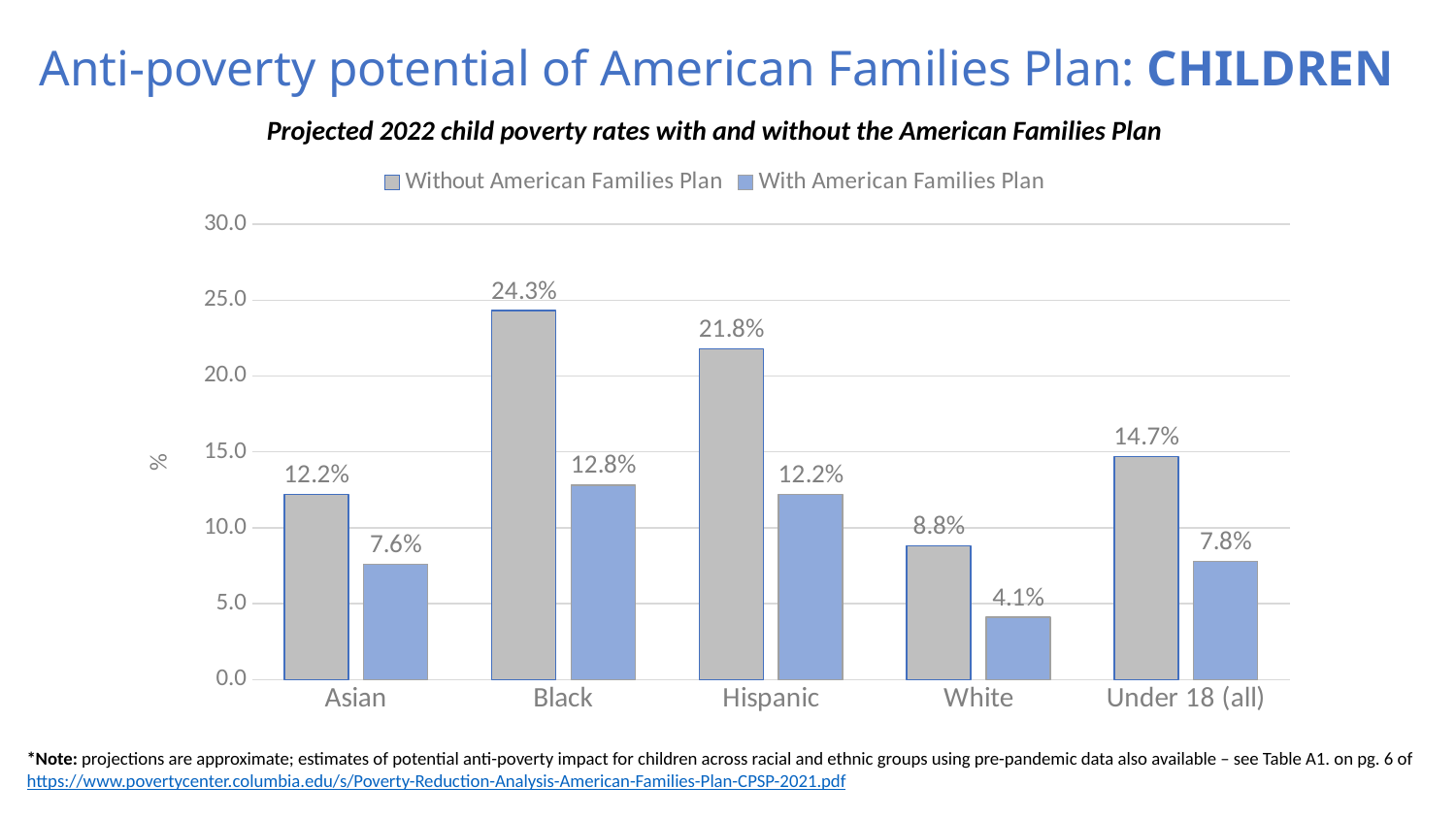
What is the value for Under 18 (all) with the American Families Plan? 7.8% Which is larger: the Asian rate without the plan or the Black rate with the plan? Black rate with the plan What is the projected child poverty rate for White children with the American Families Plan? 4.1% Is the value for Under 18 (all) without the American Families Plan greater or less than 15.0? less How many groups are shown on the x axis? 5 What kind of chart is shown on the slide? Bar chart Which group has the lowest poverty rate with the American Families Plan? White How many series does the legend list? 2 What is the chart's subtitle? Projected 2022 child poverty rates with and without the American Families Plan What is the difference between the Hispanic poverty rate without and with the American Families Plan? 9.6 percentage points What is the projected child poverty rate for Black children without the American Families Plan? 24.3% Which group has the highest poverty rate without the American Families Plan? Black